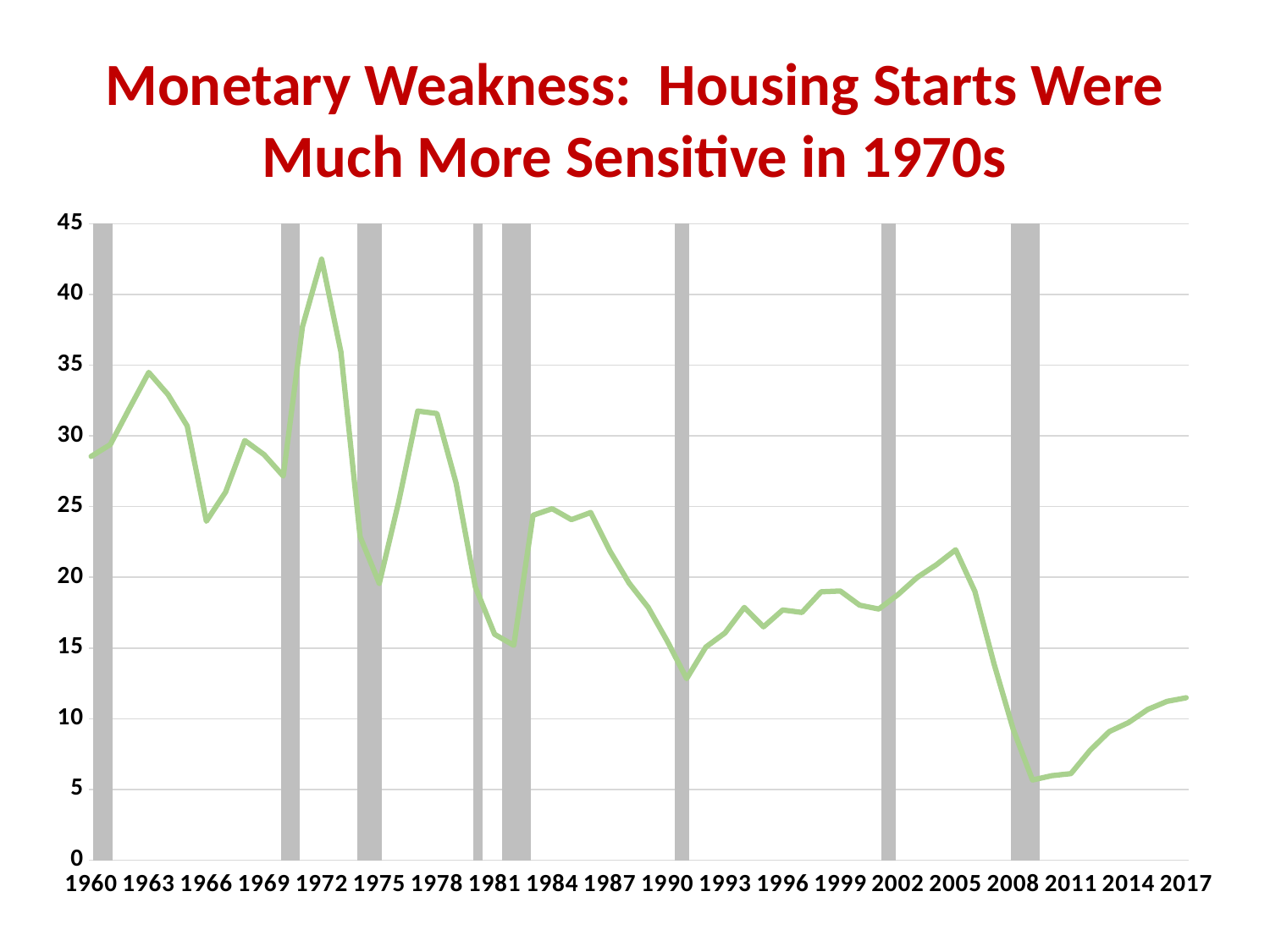
Is the peak value of the line around 1972 greater or less than 40? greater What kind of chart is shown on the slide? line chart Is the value for 2017 greater or less than 10? greater How many year labels are shown on the x axis? 20 Is the value for 1978 greater or less than 30? greater Does the line rise or fall between 1984 and 1990? fall What is the title of the chart? Monetary Weakness: Housing Starts Were Much More Sensitive in 1970s Which year has the larger value, 1960 or 2017? 1960 Around which labeled year does the line reach its highest value? 1972 Does the line rise or fall between 2011 and 2017? rise